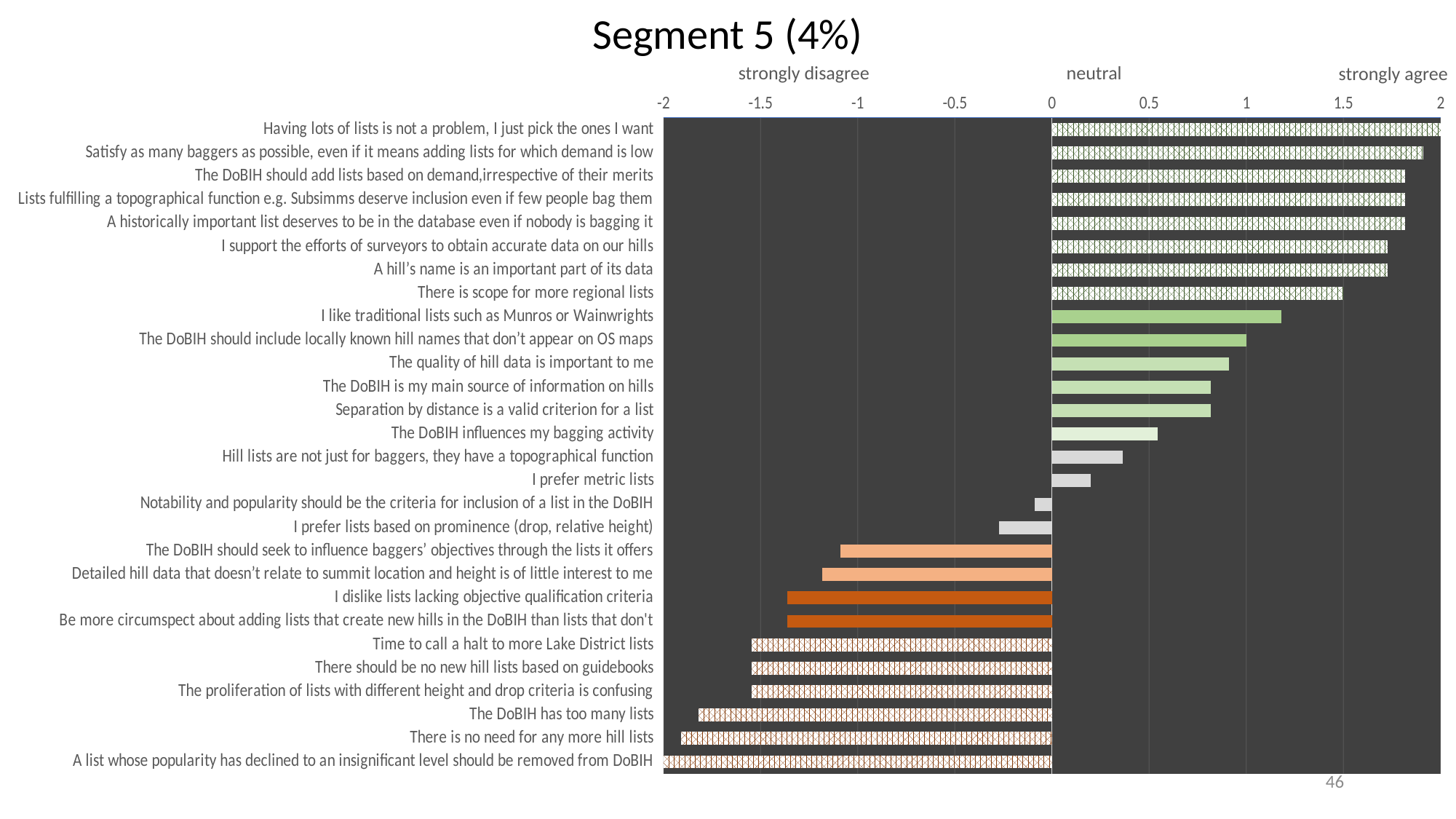
Is the value for "I like traditional lists such as Munros or Wainwrights" greater or less than 1? greater What label is shown at the centre (0) of the horizontal axis? neutral How many statements (categories) are plotted in the chart? 28 Is the value for "I dislike lists lacking objective qualification criteria" greater or less than -1? less What kind of chart is shown on the slide? bar chart Which has the larger value: "I like traditional lists such as Munros or Wainwrights" or "The quality of hill data is important to me"? I like traditional lists such as Munros or Wainwrights Is the value for "Hill lists are not just for baggers, they have a topographical function" greater or less than 0.5? less Which statement has the highest value in the chart? Having lots of lists is not a problem, I just pick the ones I want Which statement has the lowest value in the chart? A list whose popularity has declined to an insignificant level should be removed from DoBIH What is the title of the chart? Segment 5 (4%)